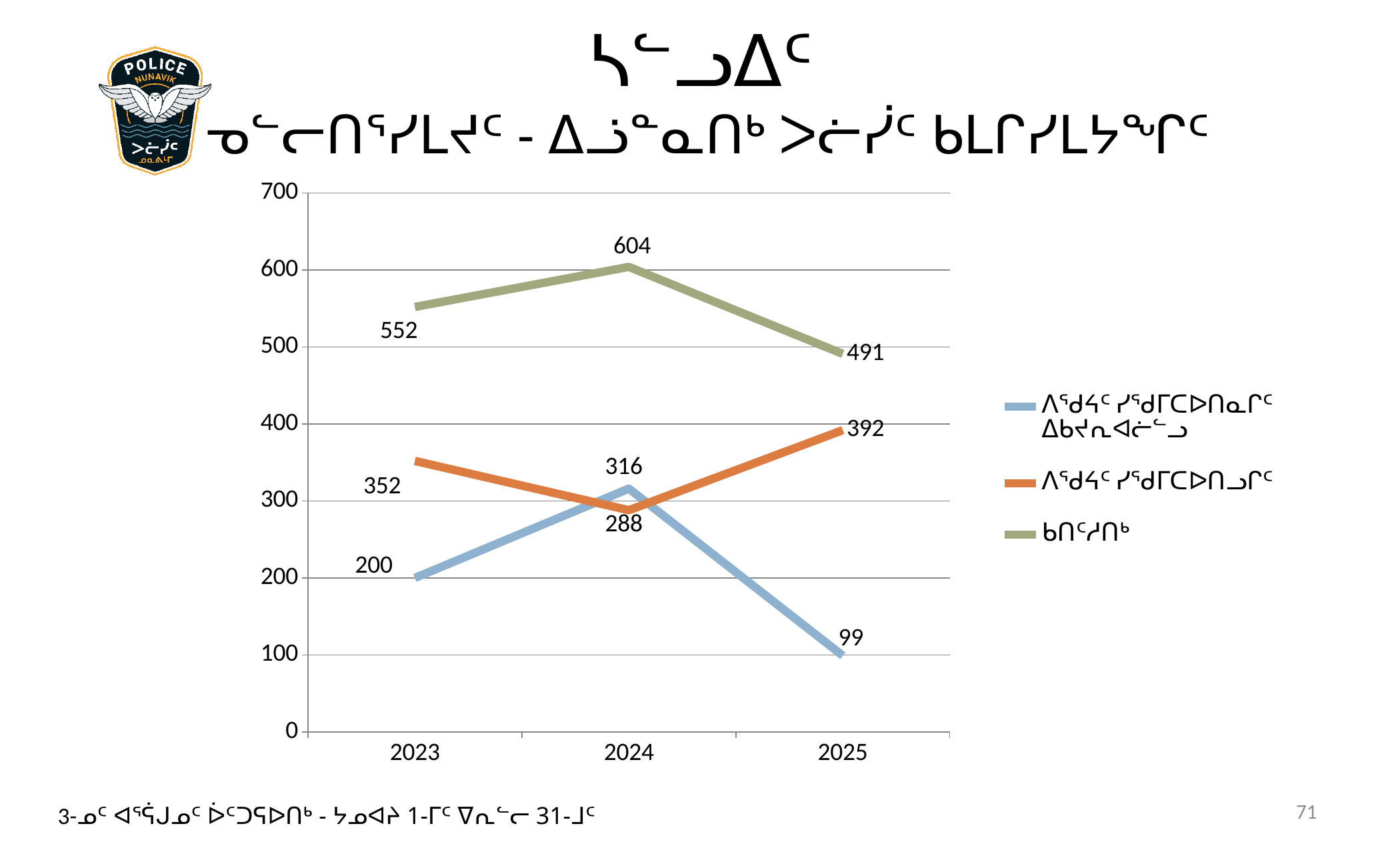
How many years are shown on the x axis? 3 What is the value of the orange line in 2025? 392 In which year does the green line reach its highest value? 2024 How many series does the legend list? 3 What is the difference between the green line's values in 2024 and 2025? 113 What kind of chart is shown on the slide? line chart In which year does the blue line have its lowest value? 2025 Does the blue line rise or fall from 2024 to 2025? fall Which is larger in 2024, the blue line or the orange line? the blue line What is the difference between the orange line's values in 2023 and 2024? 64 What is the value of the green line in 2023? 552 What is the value of the blue line in 2024? 316